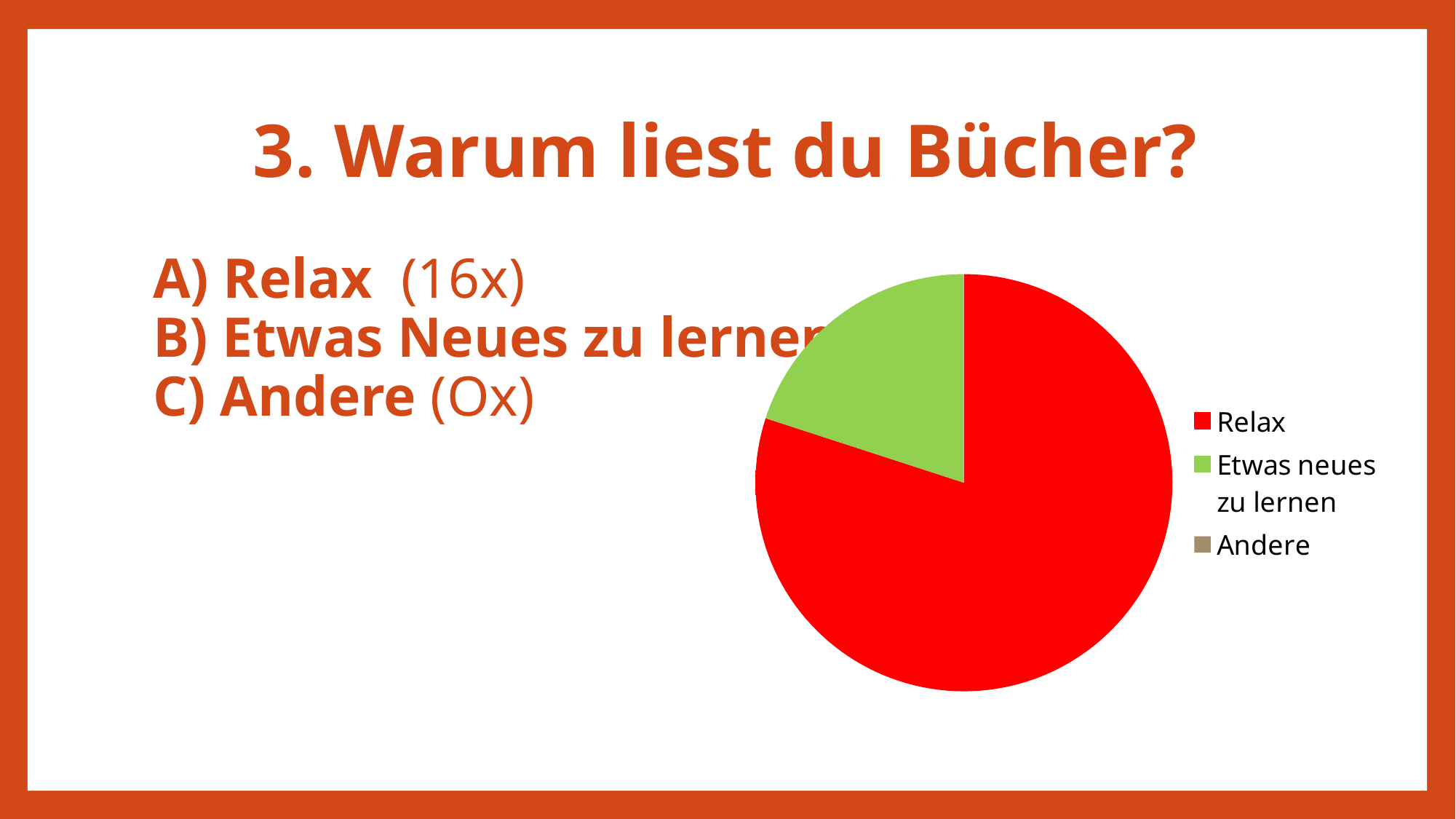
How many times was Andere chosen, according to the text on the slide? 0x Which category has the largest slice of the pie chart? Relax Which is larger in the pie chart, Relax or Etwas neues zu lernen? Relax How many times was Relax chosen, according to the text on the slide? 16x What colour is the Etwas neues zu lernen slice of the pie chart? green What colour is the Relax slice of the pie chart? red How many categories does the legend of the pie chart list? 3 What kind of chart is shown on the slide? pie chart Which category has the smallest share of the pie chart? Andere